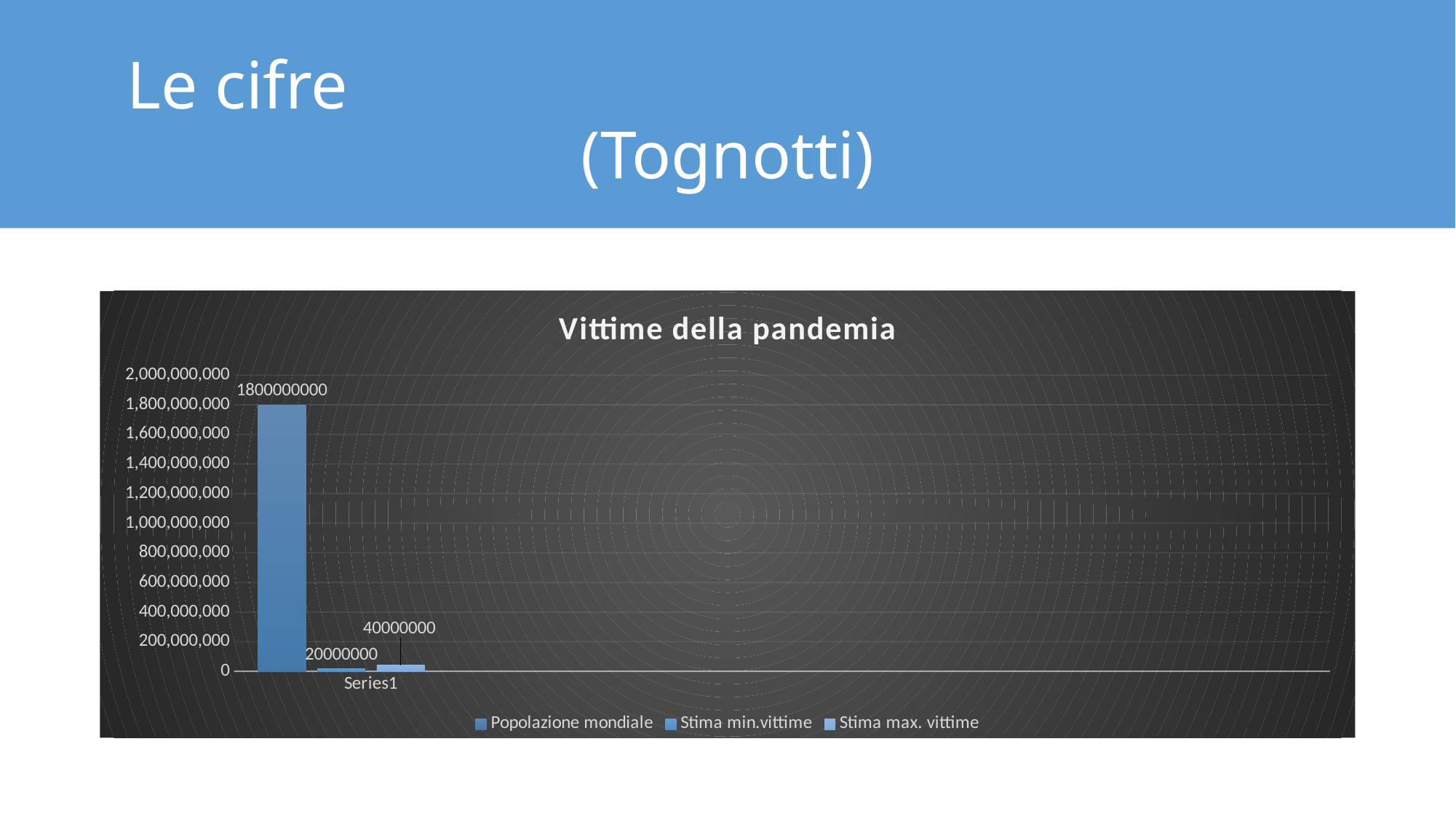
What is the value of the Stima min.vittime bar? 20000000 Which series has the highest value? Popolazione mondiale Which series has the lowest value? Stima min.vittime What kind of chart is shown on the slide? bar chart Is the value for Popolazione mondiale greater or less than 1,600,000,000? greater What is the difference between the Popolazione mondiale and Stima max. vittime values? 1760000000 How many series does the legend list? 3 Which is larger, Stima max. vittime or Stima min.vittime? Stima max. vittime What is the value of the Popolazione mondiale bar? 1800000000 What is the value of the Stima max. vittime bar? 40000000 What is the title of the chart? Vittime della pandemia What is the difference between the Stima max. vittime and Stima min.vittime values? 20000000